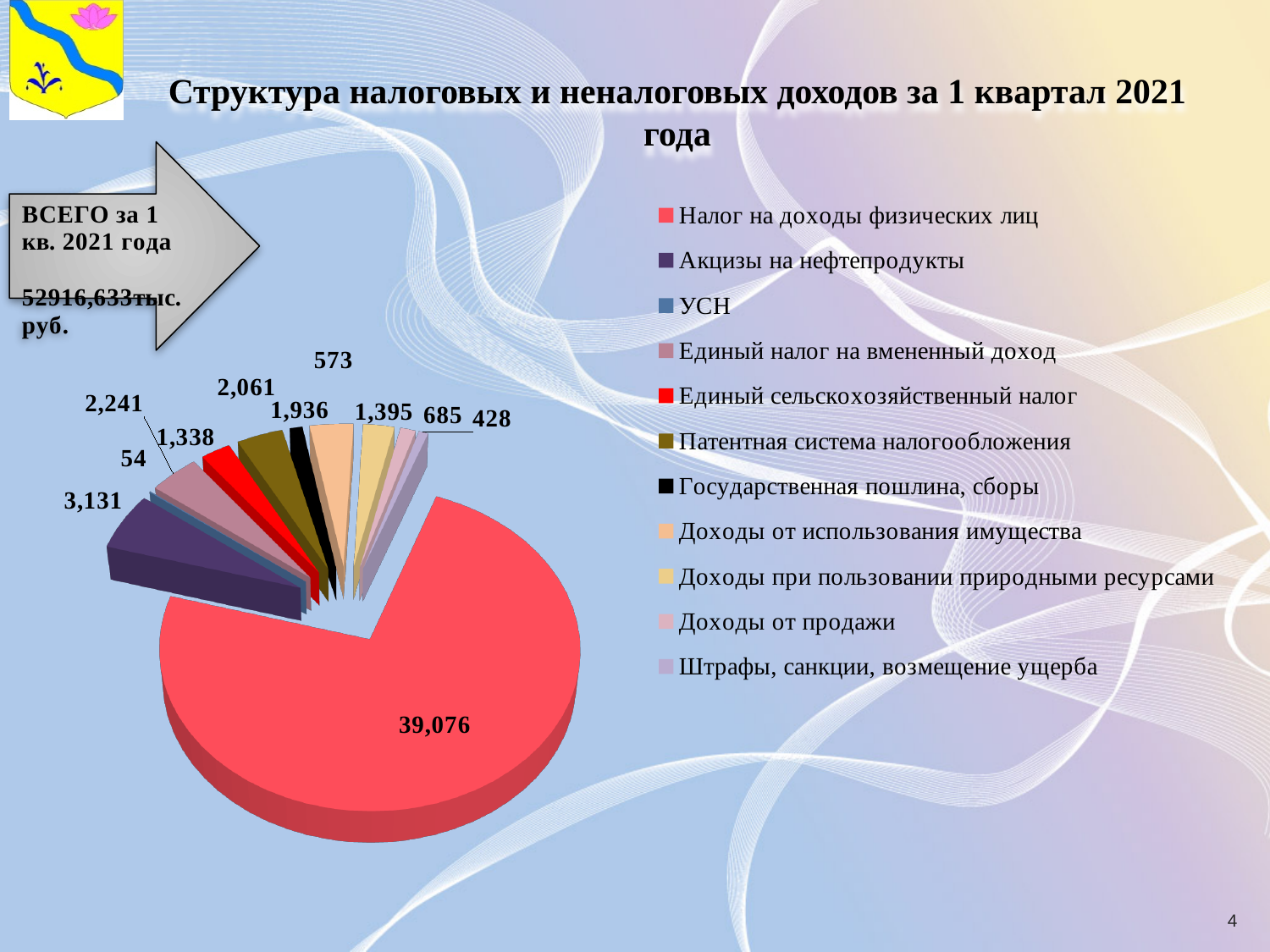
What is the value for Налог на доходы физических лиц? 39,076 Which category has the largest slice of the pie? Налог на доходы физических лиц What is the value for УСН? 54 What kind of chart is shown on the slide? pie chart What is the value for Штрафы, санкции, возмещение ущерба? 428 What is the title of the slide containing the chart? Структура налоговых и неналоговых доходов за 1 квартал 2021 года Which is larger: Доходы от использования имущества or Доходы при пользовании природными ресурсами? Доходы от использования имущества What is the difference between the values for Налог на доходы физических лиц and Акцизы на нефтепродукты? 35,945 Which category has the smallest slice of the pie? УСН How many categories does the pie chart have? 11 What is the value for Акцизы на нефтепродукты? 3,131 What is the value for Патентная система налогообложения? 2,061